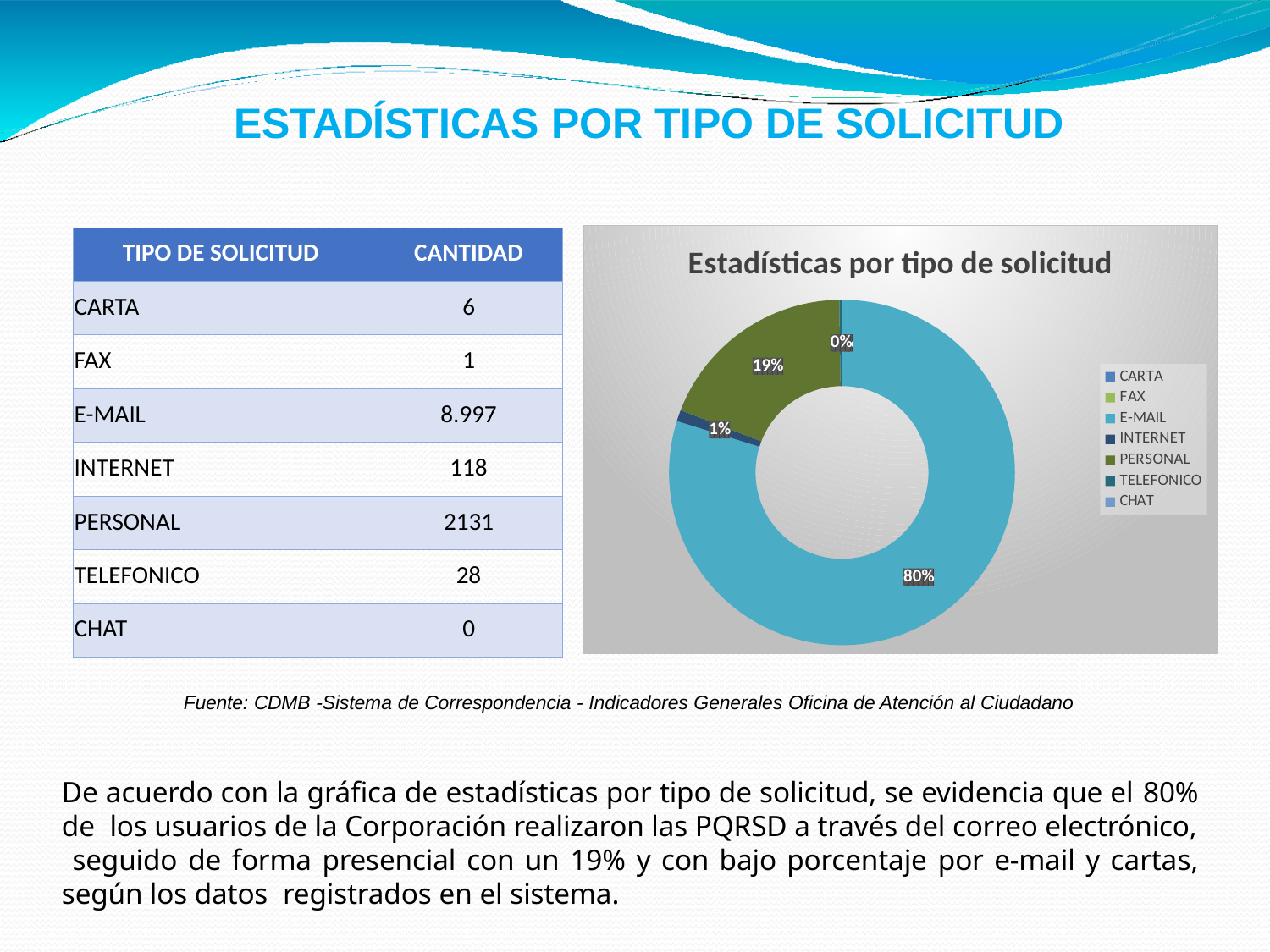
Which category has the largest slice in the doughnut chart? E-MAIL What is the difference in percentage points between the E-MAIL slice and the PERSONAL slice? 61% What share of the doughnut chart does E-MAIL represent? 80% Which is larger in the doughnut chart, the E-MAIL slice or the PERSONAL slice? E-MAIL Which legend entry is listed first in the chart legend? CARTA What share of the doughnut chart does PERSONAL represent? 19% Which is larger in the doughnut chart, the PERSONAL slice or the INTERNET slice? PERSONAL What is the title of the chart? Estadísticas por tipo de solicitud What share of the doughnut chart does INTERNET represent? 1% What is the combined share of the E-MAIL and PERSONAL slices? 99% How many entries does the chart legend list? 7 What kind of chart is shown on the slide? doughnut chart